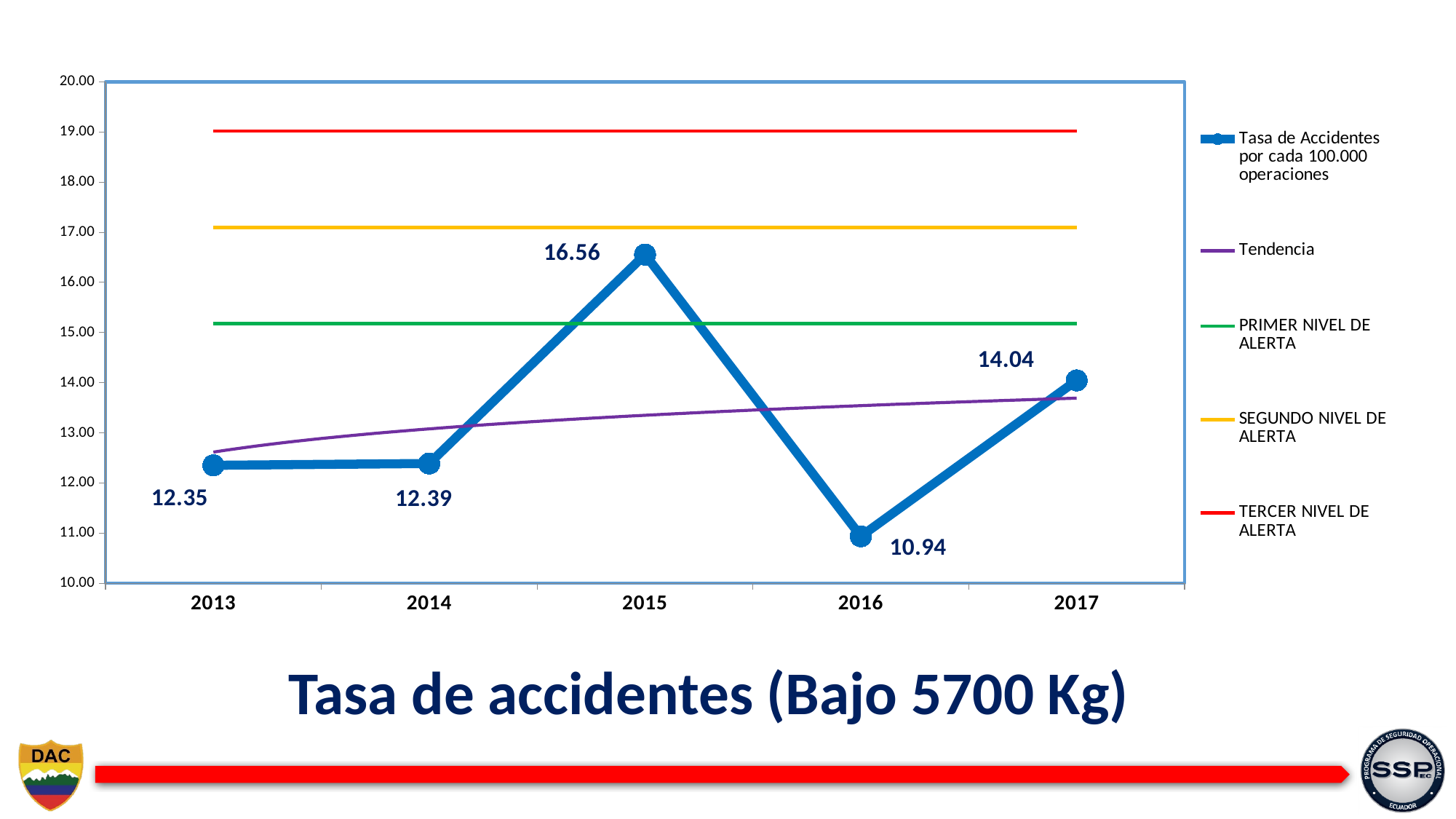
Is the PRIMER NIVEL DE ALERTA line greater or less than 15.00? greater What type of chart is shown on the slide? Line chart Is the accident rate higher in 2017 or in 2014? 2017 What is the accident rate for 2017? 14.04 What is the accident rate for 2013? 12.35 How many series does the legend list? 5 Which year has the lowest accident rate? 2016 How many years are shown on the x axis? 5 What is the accident rate (Tasa de Accidentes por cada 100.000 operaciones) for 2015? 16.56 What is the accident rate for 2016? 10.94 Which year has the highest accident rate? 2015 What is the difference between the accident rate in 2015 and in 2016? 5.62